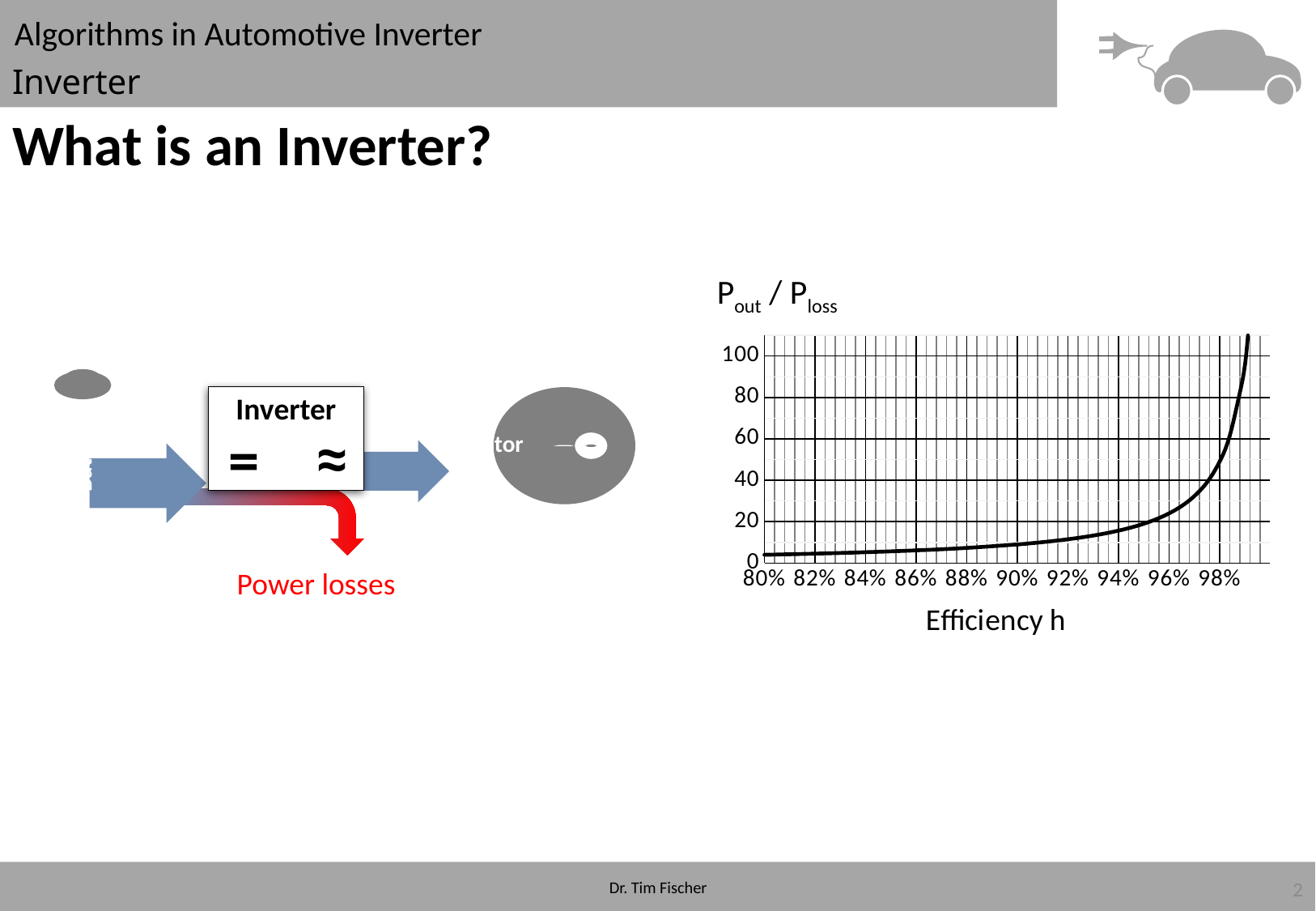
Is the value of Pout / Ploss at 90% efficiency greater or less than 20? less At which end of the x axis does the curve reach its highest value? the right end (highest efficiency) Is the value of Pout / Ploss at 80% efficiency greater or less than 20? less Is the value of Pout / Ploss at 94% efficiency greater or less than 40? less What is the highest labelled value on the y axis? 100 What is the label of the x axis? Efficiency h Does the plotted value rise or fall as efficiency increases along the x axis? rise What quantity is plotted on the y axis? Pout / Ploss What kind of chart is shown on the slide? line chart How many labelled tick marks are on the x axis? 10 Which is larger, the value of Pout / Ploss at 98% efficiency or at 90% efficiency? 98%